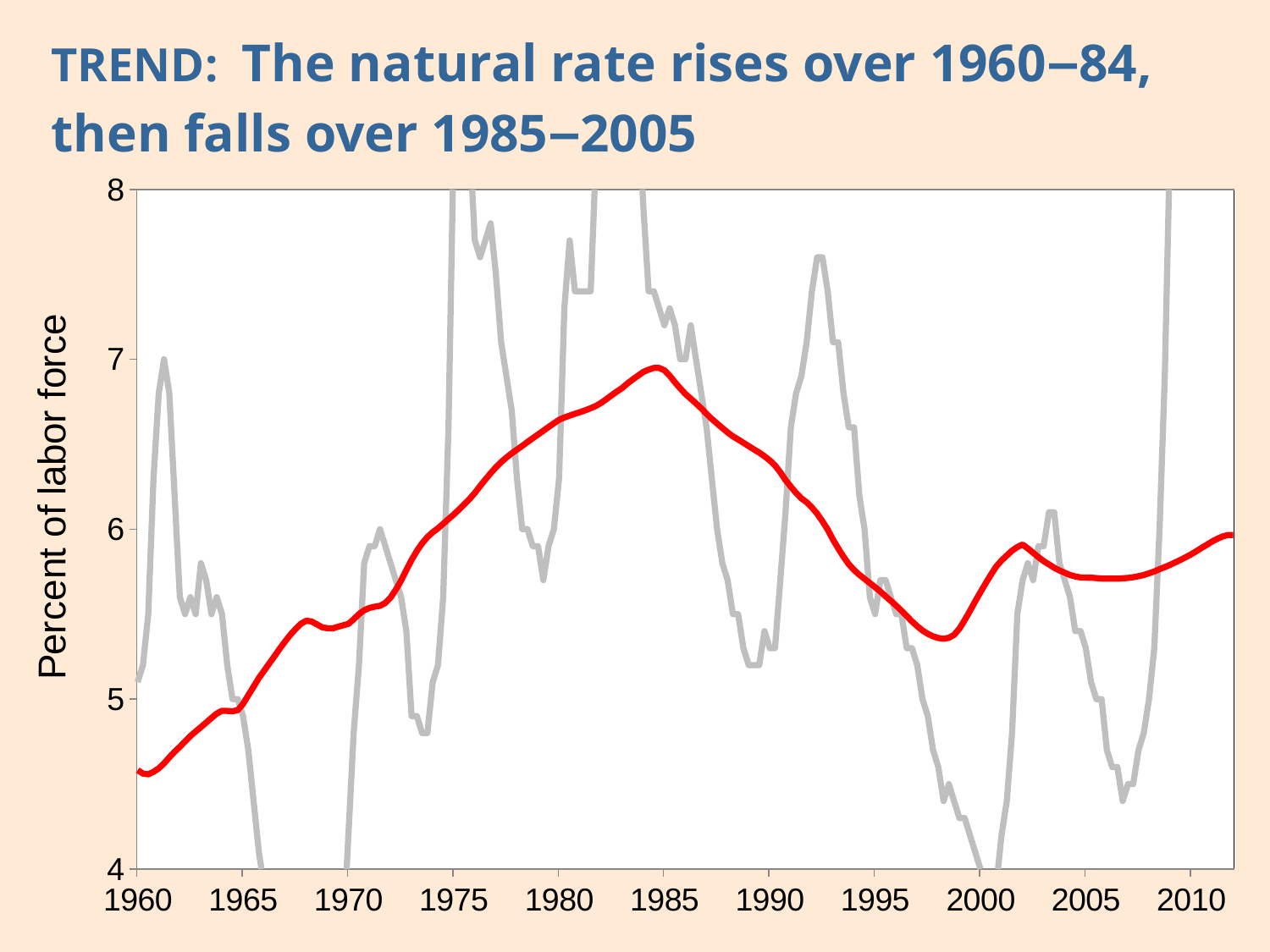
Around which year does the red line reach its highest value? 1985 Does the red line rise or fall between 1960 and 1985? rises Is the value of the red line in 2010 greater or less than 6? less Is the value of the red line in 1985 greater or less than 6? greater What kind of chart is shown on the slide? line chart What is the label on the vertical axis? Percent of labor force What is the title of the slide's chart? TREND: The natural rate rises over 1960–84, then falls over 1985–2005 Is the value of the red line in 1960 greater or less than 5? less Which is larger, the red line's value in 1990 or its value in 2000? 1990 How many lines are plotted on the chart? 2 Around which year is the red line at its lowest value? 1960 Does the red line rise or fall between 1985 and 2000? falls